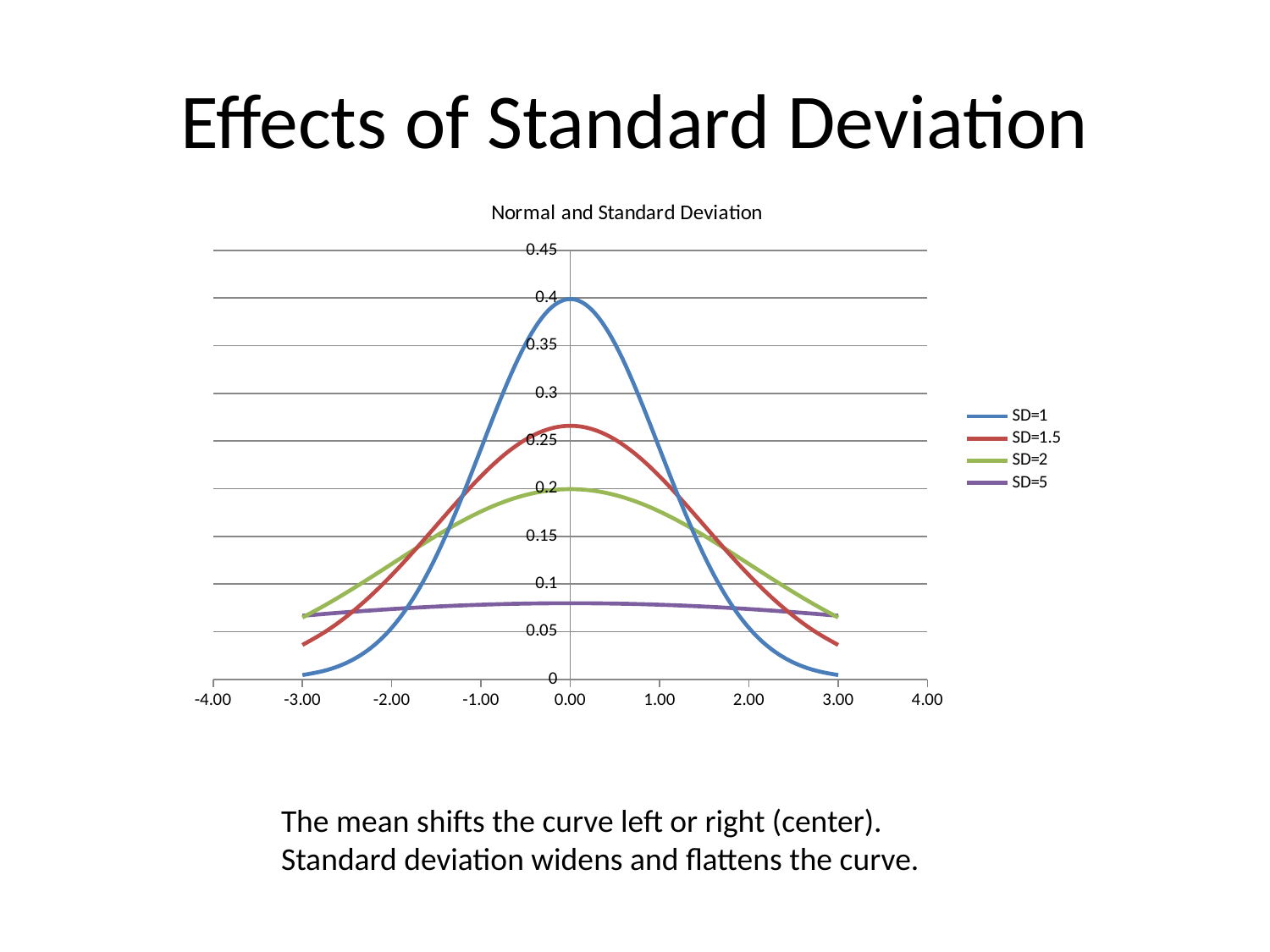
At x = 0.00, which series has the larger value, SD=1 or SD=2? SD=1 Is the value of the SD=1 series at x = 0.00 greater or less than 0.35? greater At x = 3.00, which series has the larger value, SD=1 or SD=5? SD=5 What is the title of the chart? Normal and Standard Deviation Does the SD=1 series rise or fall as x goes from 0.00 to 3.00? fall Is the value of the SD=1.5 series at x = 0.00 greater or less than 0.3? less How many series does the legend list? 4 What kind of chart is shown on the slide? line chart Is the value of the SD=2 series at x = 0.00 greater or less than 0.15? greater Which series reaches the highest peak value? SD=1 Which series has the lowest peak value? SD=5